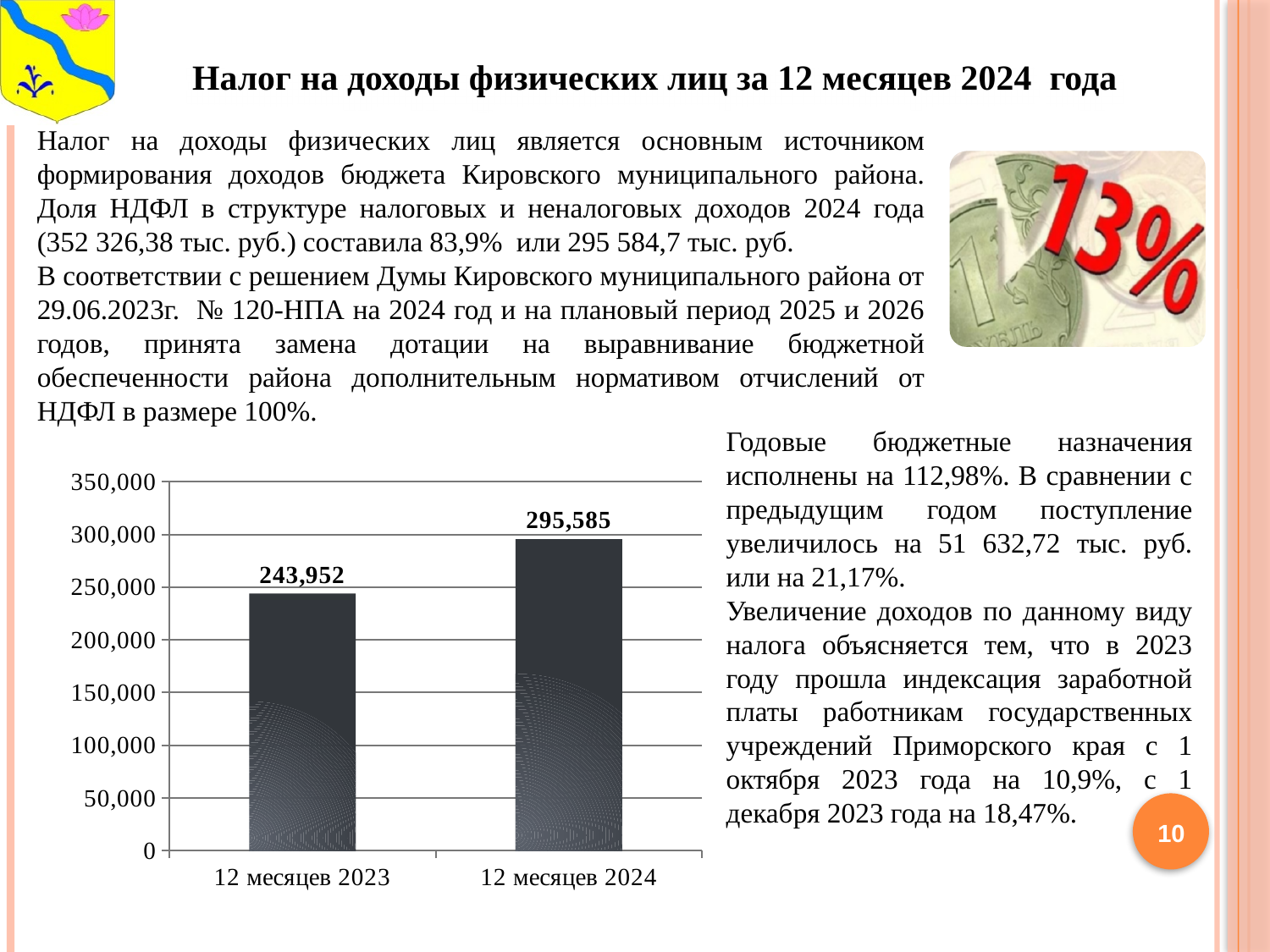
What is the highest value shown on the vertical axis of the chart? 350,000 Which category has the highest value? 12 месяцев 2024 Do the values rise or fall from 12 месяцев 2023 to 12 месяцев 2024? rise What is the value for 12 месяцев 2023? 243,952 What kind of chart is shown on the slide? bar chart Which is larger, the value for 12 месяцев 2023 or for 12 месяцев 2024? 12 месяцев 2024 Is the value for 12 месяцев 2023 greater or less than 250,000? less Is the value for 12 месяцев 2024 greater or less than 250,000? greater What is the value for 12 месяцев 2024? 295,585 How many categories are shown on the chart? 2 What is the difference between the values for 12 месяцев 2024 and 12 месяцев 2023? 51,633 Which category has the lowest value? 12 месяцев 2023